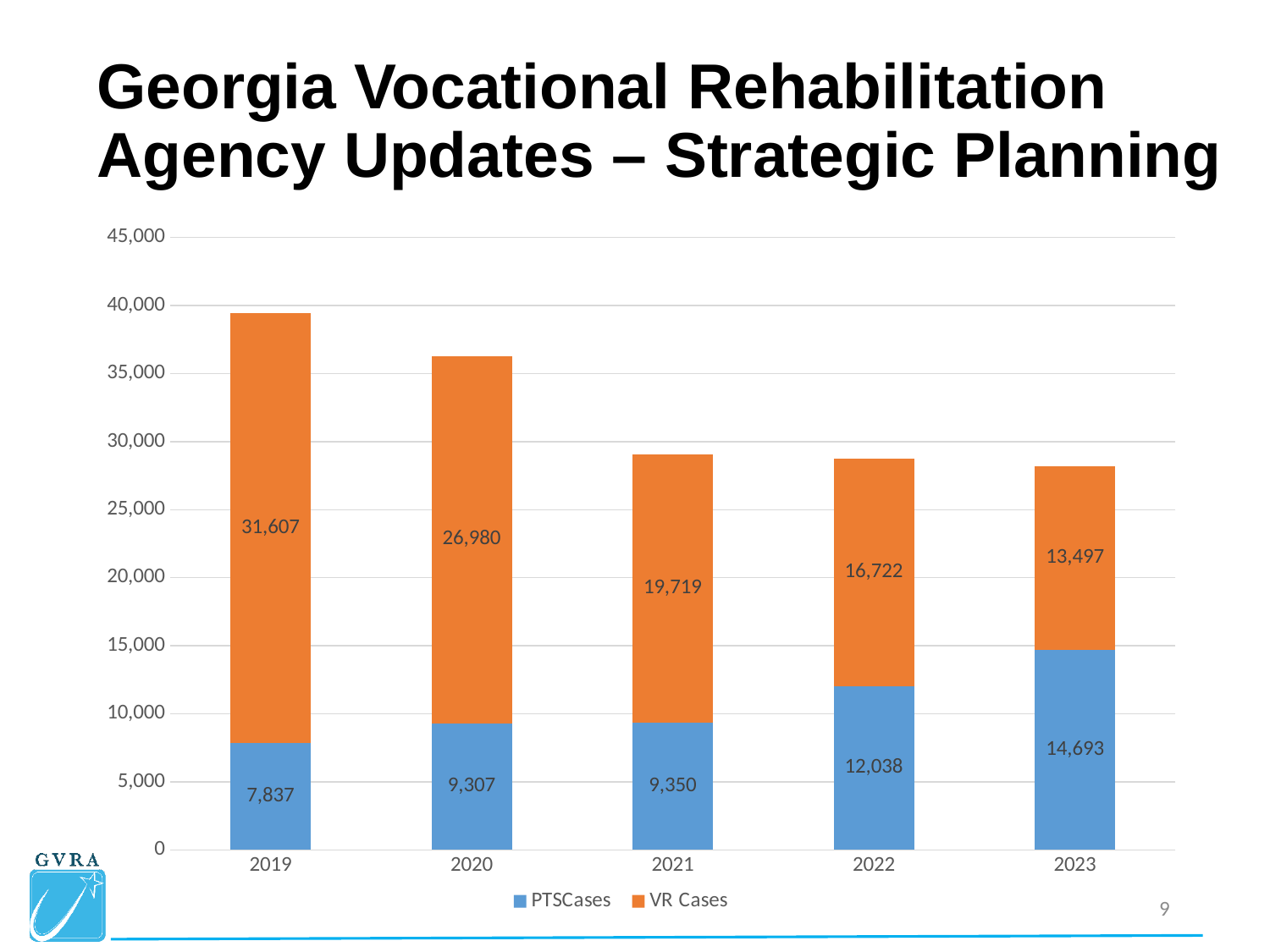
Is the total height of the 2021 bar greater or less than 30,000? less How many series does the legend list? 2 In 2023, which is larger: PTS Cases or VR Cases? PTS Cases What kind of chart is shown on the slide? Stacked bar chart What is the value for PTS Cases in 2023? 14,693 What is the total of the stacked bar for 2019? 39,444 What is the difference between VR Cases in 2019 and VR Cases in 2020? 4,627 Do the VR Cases values rise or fall from 2019 to 2023? Fall What is the value for VR Cases in 2019? 31,607 Which year has the highest number of VR Cases? 2019 How many years are shown on the x axis? 5 Which year has the lowest number of PTS Cases? 2019